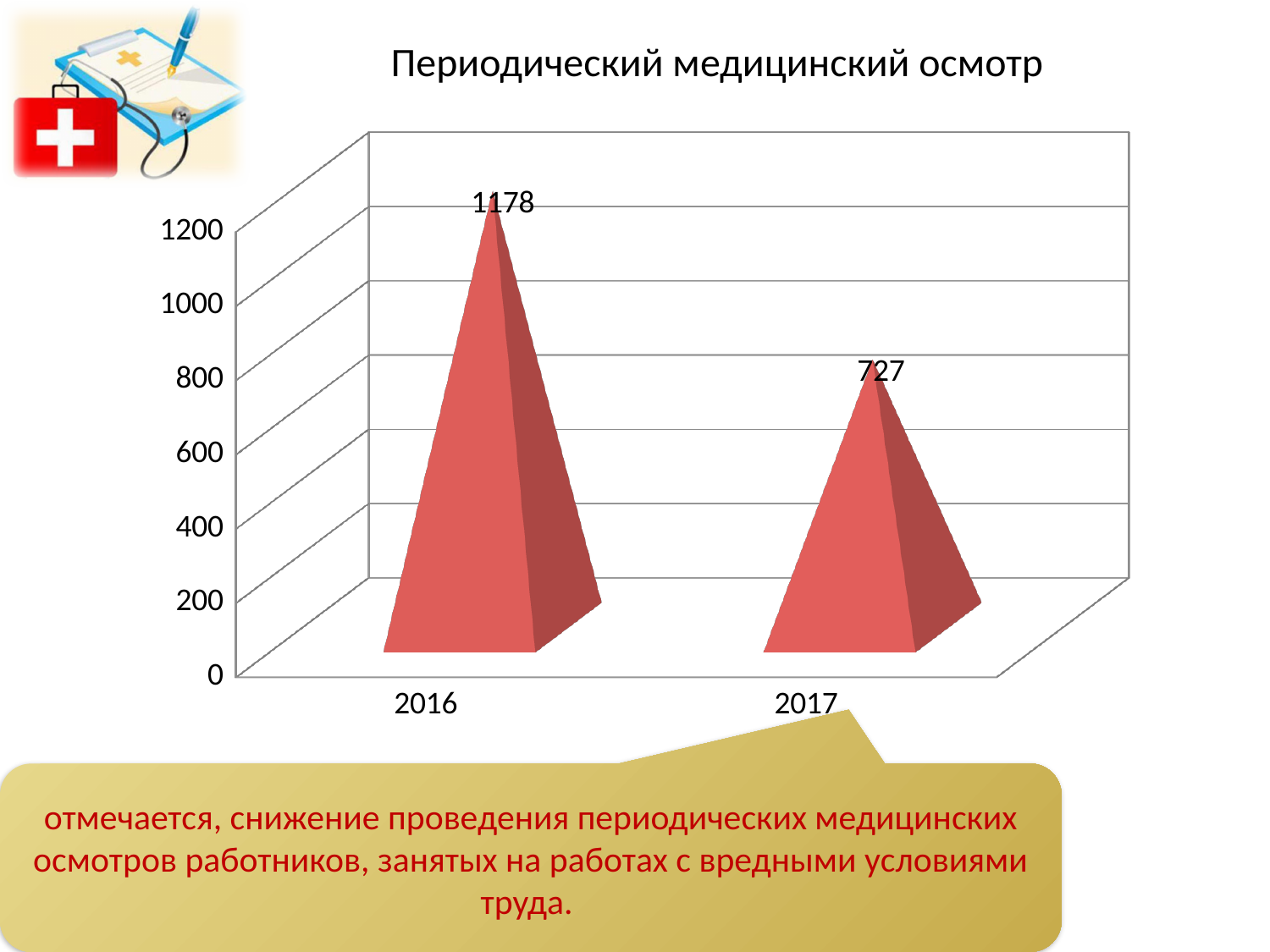
How many categories are shown on the x axis? 2 Which year has the highest value? 2016 Is the value for 2017 greater or less than 800? less What is the difference between the values for 2016 and 2017? 451 Is the value for 2016 greater or less than 1000? greater What is the value for 2016? 1178 What kind of chart is shown on the slide? bar chart Which year has the lowest value? 2017 What is the title of the chart? Периодический медицинский осмотр What is the value for 2017? 727 Do the values rise or fall from 2016 to 2017? fall Which is larger, the value for 2016 or the value for 2017? 2016